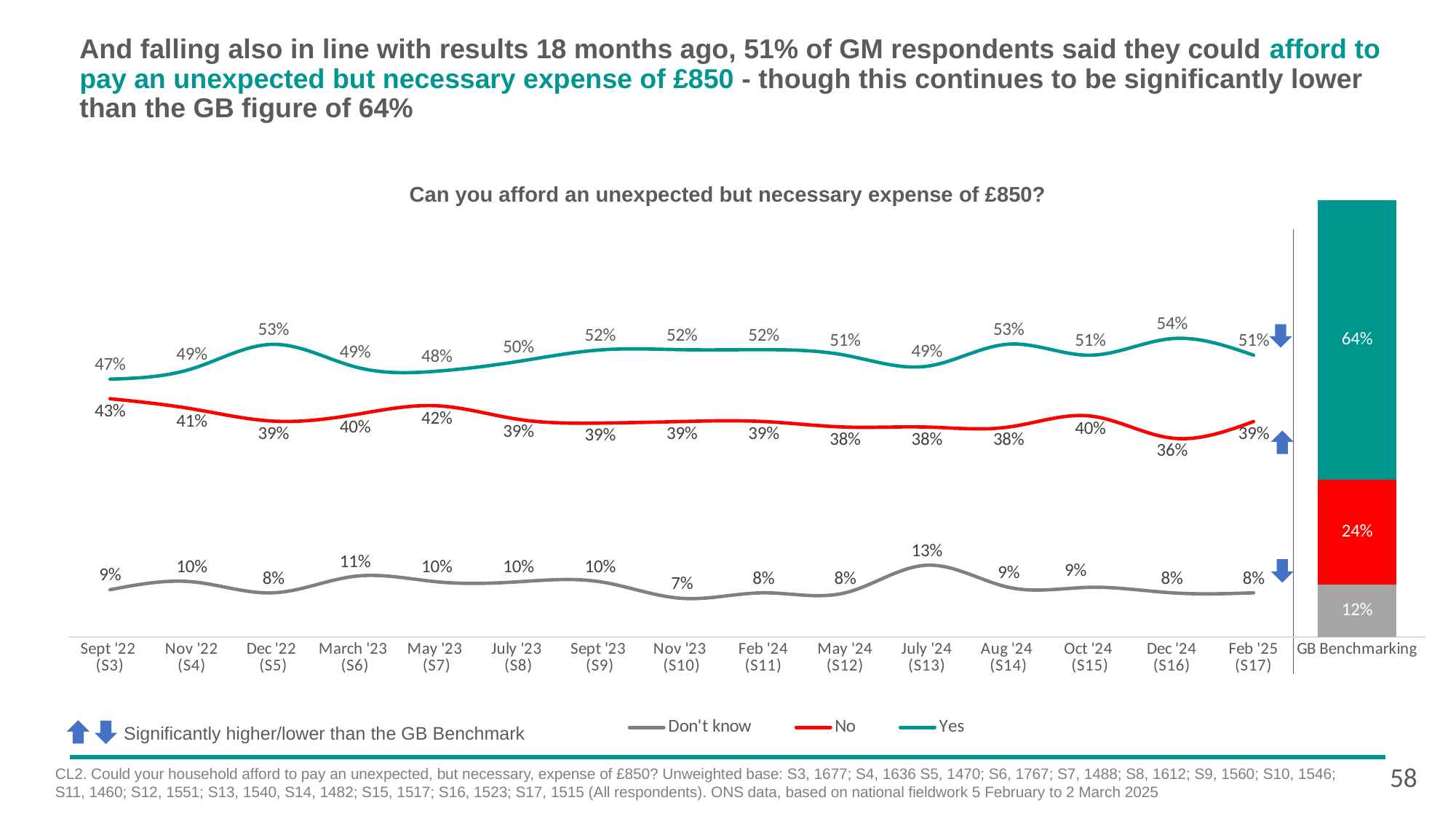
In which survey wave does the 'Yes' line reach its highest value? Dec '24 (S16) What is the 'No' value for Dec '24 (S16)? 36% What is the difference between the GB Benchmarking 'Yes' value and the Feb '25 'Yes' value? 13% What is the total of the GB Benchmarking stacked bar? 100% What is the 'Yes' value shown for the GB Benchmarking bar? 64% Which is larger: the 'No' value in Sept '22 or the 'No' value in Feb '25? Sept '22 How many survey waves (time points) are plotted on the line chart, excluding the GB Benchmarking bar? 15 In which survey wave is the 'Yes' value lowest? Sept '22 (S3) How many series does the legend list? 3 What colour is the 'No' line in the chart? Red In which survey wave is the 'Don't know' value highest? July '24 (S13) What percentage of respondents answered 'Yes' in Feb '25 (S17)? 51%